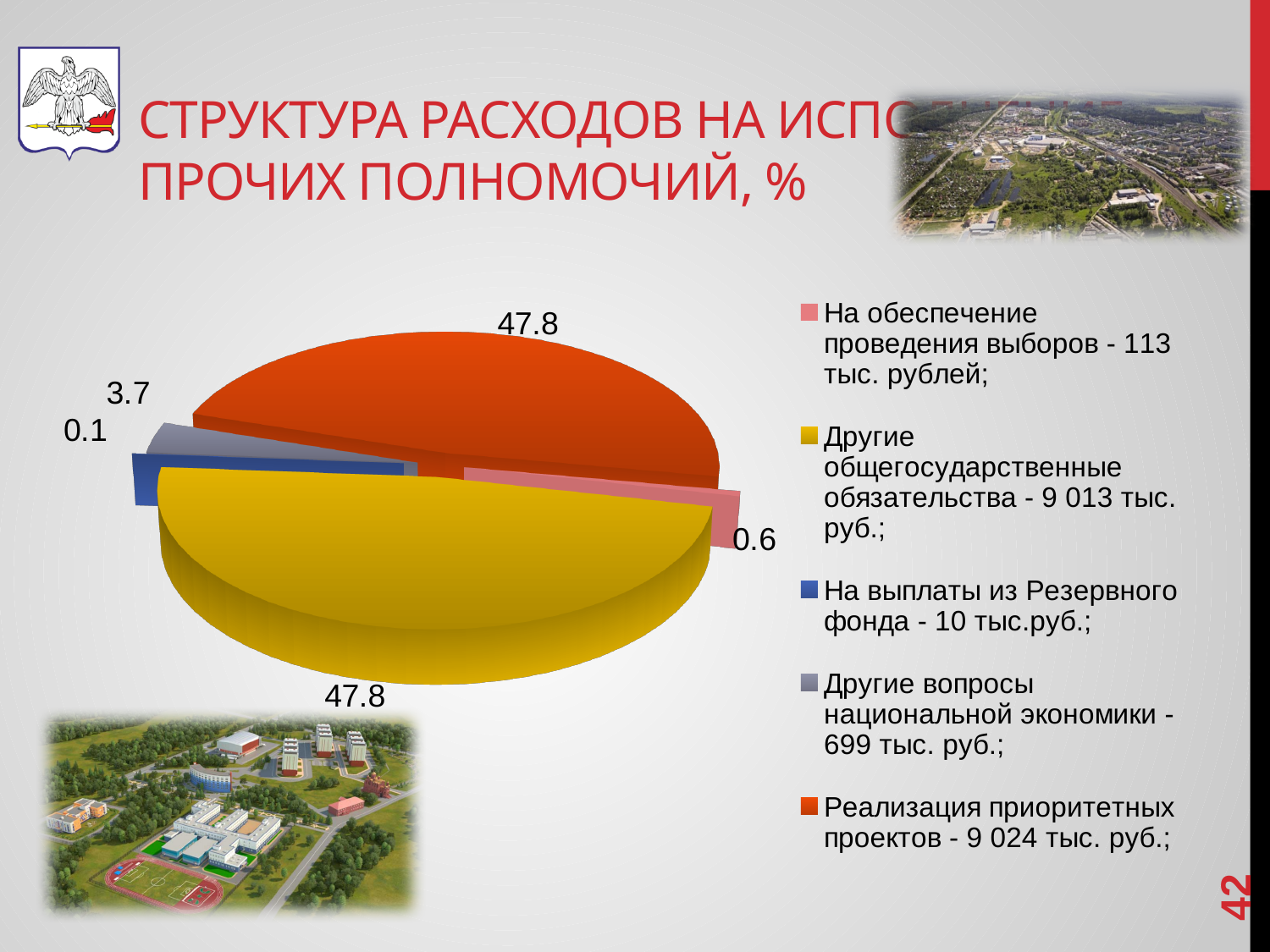
What value is shown for 'На выплаты из Резервного фонда' in the pie chart? 0.1 How many entries does the legend list? 5 What value is shown for 'Другие вопросы национальной экономики' in the pie chart? 3.7 Which category has the smallest slice in the pie chart? На выплаты из Резервного фонда What is the difference between the values for 'Другие вопросы национальной экономики' and 'На обеспечение проведения выборов'? 3.1 What type of chart is shown on the slide? Pie chart What is the difference between the values for 'Другие общегосударственные обязательства' and 'Другие вопросы национальной экономики'? 44.1 What value is shown for 'На обеспечение проведения выборов' in the pie chart? 0.6 What percentage share does the slice 'Реализация приоритетных проектов' have in the pie chart? 47.8 Which is larger: the slice for 'Другие вопросы национальной экономики' or the slice for 'На обеспечение проведения выборов'? Другие вопросы национальной экономики How many slices does the pie chart have? 5 According to the legend, what amount in thousand rubles corresponds to 'Реализация приоритетных проектов'? 9 024 тыс. руб.